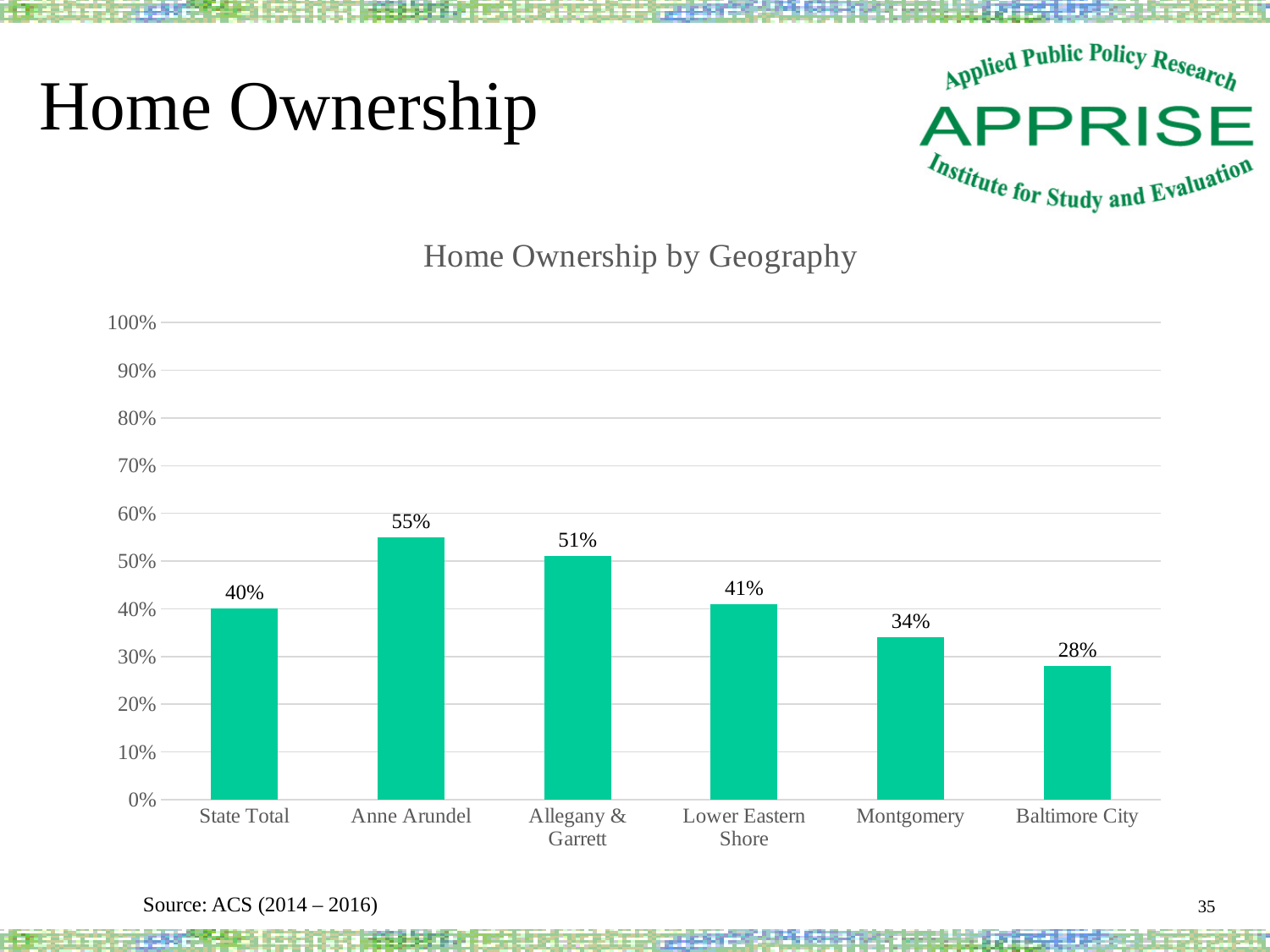
What is the title of the chart? Home Ownership by Geography What is the home ownership rate for Anne Arundel? 55% Which has a higher home ownership rate, Lower Eastern Shore or Montgomery? Lower Eastern Shore How many geographies are shown in the chart? 6 Which geography has the lowest home ownership rate? Baltimore City What is the home ownership rate for Baltimore City? 28% What is the State Total home ownership rate? 40% What kind of chart is shown on the slide? Bar chart What is the difference in home ownership rate between Allegany & Garrett and the State Total? 11% What is the home ownership rate for Montgomery? 34% What is the difference in home ownership rate between Anne Arundel and Baltimore City? 27% Which geography has the highest home ownership rate? Anne Arundel